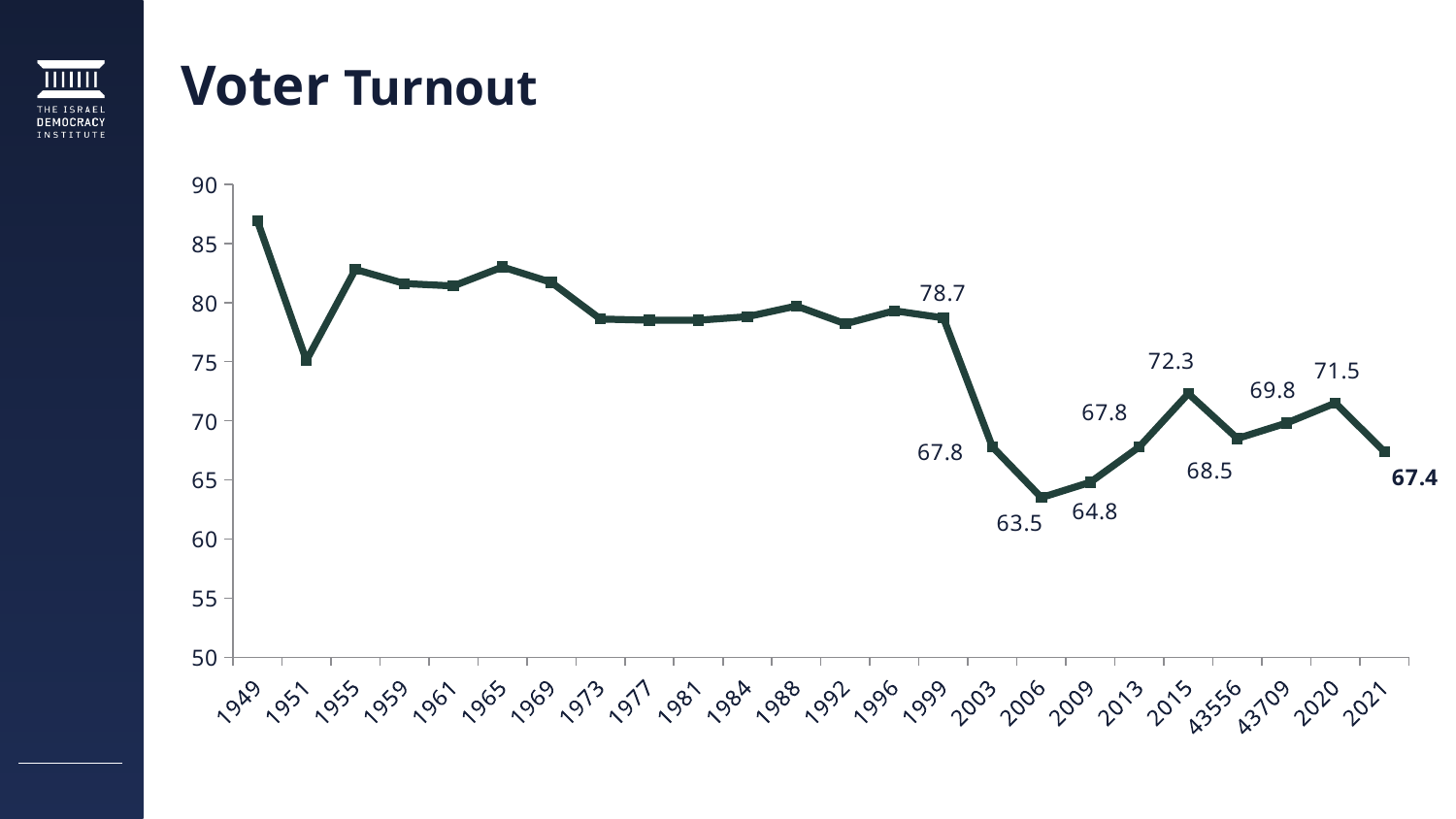
What is the difference between the voter turnout in 2015 and in 2006? 8.8 What is the voter turnout value for 2006? 63.5 How many years are plotted on the x axis? 24 What kind of chart is shown on the slide? line chart Which year has the highest voter turnout? 1949 Which year has the higher voter turnout, 2009 or 2013? 2013 Which year has the lowest voter turnout? 2006 What is the voter turnout value for 2015? 72.3 What is the voter turnout value for 1999? 78.7 What is the voter turnout value for 2021? 67.4 By how much did voter turnout fall from 2020 to 2021? 4.1 Is the voter turnout value for 1951 greater or less than 80? less